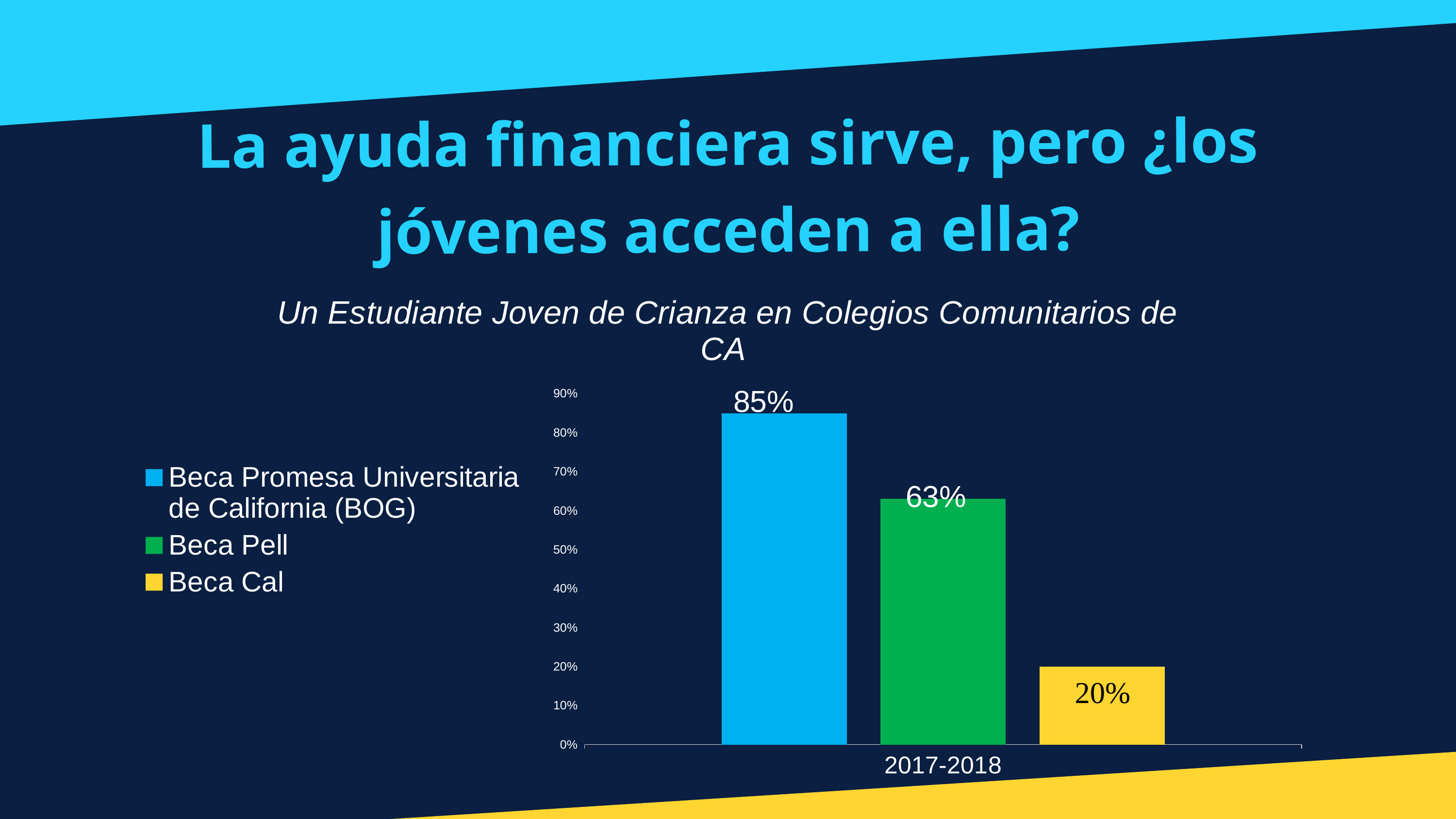
How many series does the legend list? 3 What is the title of the chart? Un Estudiante Joven de Crianza en Colegios Comunitarios de CA What colour is the bar for Beca Cal? Yellow Which series has the highest value in 2017-2018? Beca Promesa Universitaria de California (BOG) What is the value for Beca Pell in 2017-2018? 63% What is the difference between the Beca Pell value and the Beca Cal value? 43% What is the value for Beca Promesa Universitaria de California (BOG) in 2017-2018? 85% Which is larger, the value for Beca Pell or the value for Beca Cal? Beca Pell What is the difference between the Beca Promesa Universitaria de California (BOG) value and the Beca Pell value? 22% What is the value for Beca Cal in 2017-2018? 20% Which series has the lowest value in 2017-2018? Beca Cal What kind of chart is shown on the slide? Bar chart